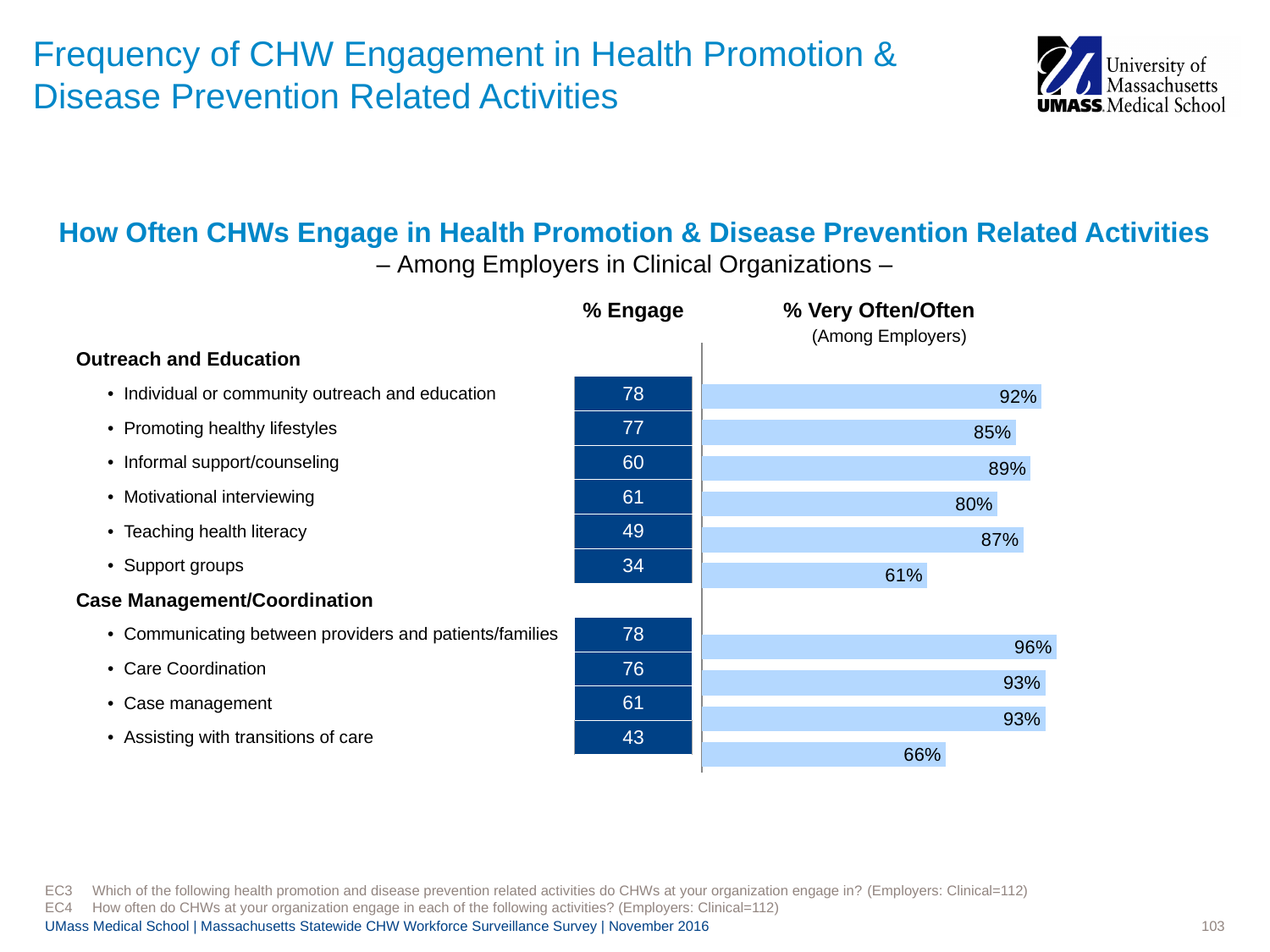
What kind of chart is used to show the % Very Often/Often values on the slide? bar chart Which activity has the lowest % Very Often/Often value? Support groups What is the % Engage value for Teaching health literacy? 49 What is the difference in % Engage between Care Coordination and Assisting with transitions of care? 33 What is the % Engage value for Support groups? 34 What is the % Very Often/Often value for Support groups? 61% Which activity has the highest % Very Often/Often value? Communicating between providers and patients/families What is the % Very Often/Often value for Individual or community outreach and education? 92% What is the difference in % Very Often/Often between Individual or community outreach and education and Promoting healthy lifestyles? 7 percentage points What is the % Very Often/Often value for Assisting with transitions of care? 66% How many activities are plotted in the % Very Often/Often bar chart? 10 Which has a higher % Very Often/Often value: Teaching health literacy or Motivational interviewing? Teaching health literacy